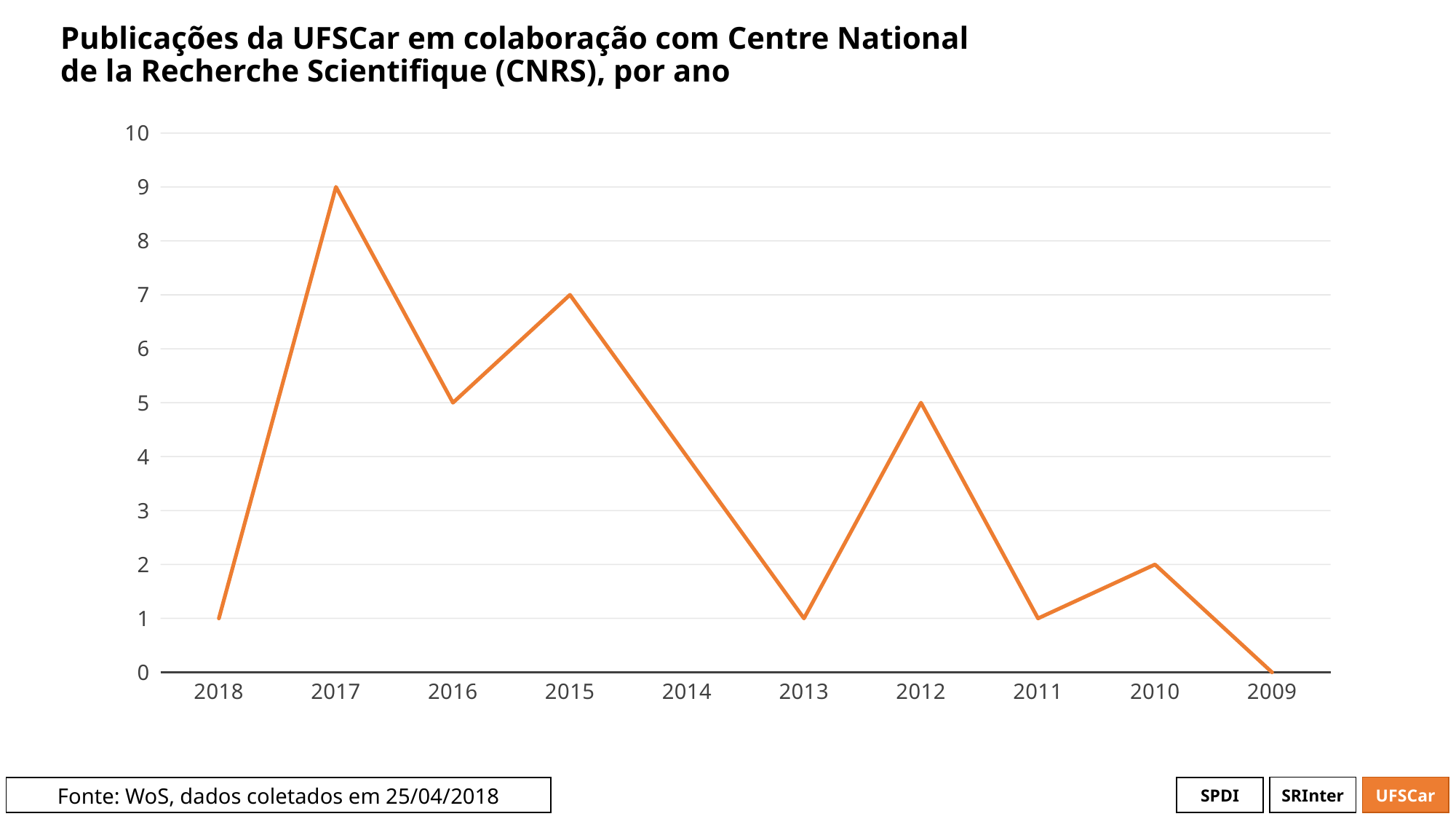
Is the value for 2014 greater or less than 6? less What is the value for 2017? 9 What type of chart is shown on the slide? line chart Which is larger, the value for 2015 or the value for 2012? 2015 What is the value for 2009? 0 What is the source cited at the bottom of the slide? WoS, dados coletados em 25/04/2018 Which year has the highest value? 2017 What is the value for 2015? 7 What is the value for 2012? 5 Which year has the lowest value? 2009 What is the difference between the values for 2017 and 2016? 4 How many years are shown on the x axis? 10